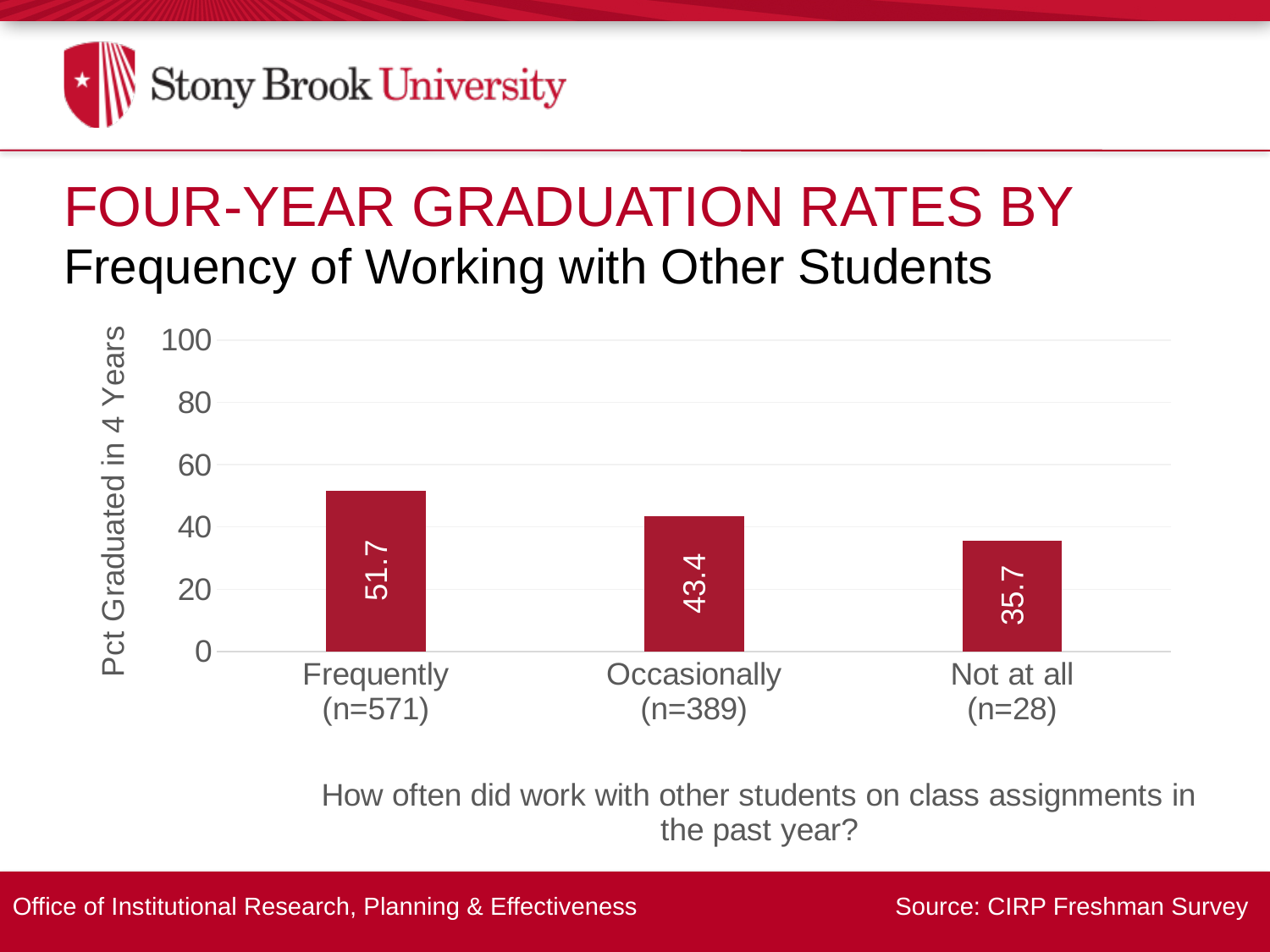
How many categories are shown on the x axis? 3 Is the value for Frequently greater or less than 60? less Which category has the lowest four-year graduation rate? Not at all What is the difference in graduation rate between the Frequently and Not at all categories? 16.0 What is the four-year graduation rate for students who worked with other students Not at all? 35.7 What kind of chart is shown on the slide? bar chart Which category has the highest four-year graduation rate? Frequently What is the label of the y axis? Pct Graduated in 4 Years What is the difference in graduation rate between the Frequently and Occasionally categories? 8.3 What is the four-year graduation rate for students who worked with other students Occasionally? 43.4 Which has a higher graduation rate, Occasionally or Not at all? Occasionally What is the four-year graduation rate for students who worked with other students Frequently? 51.7